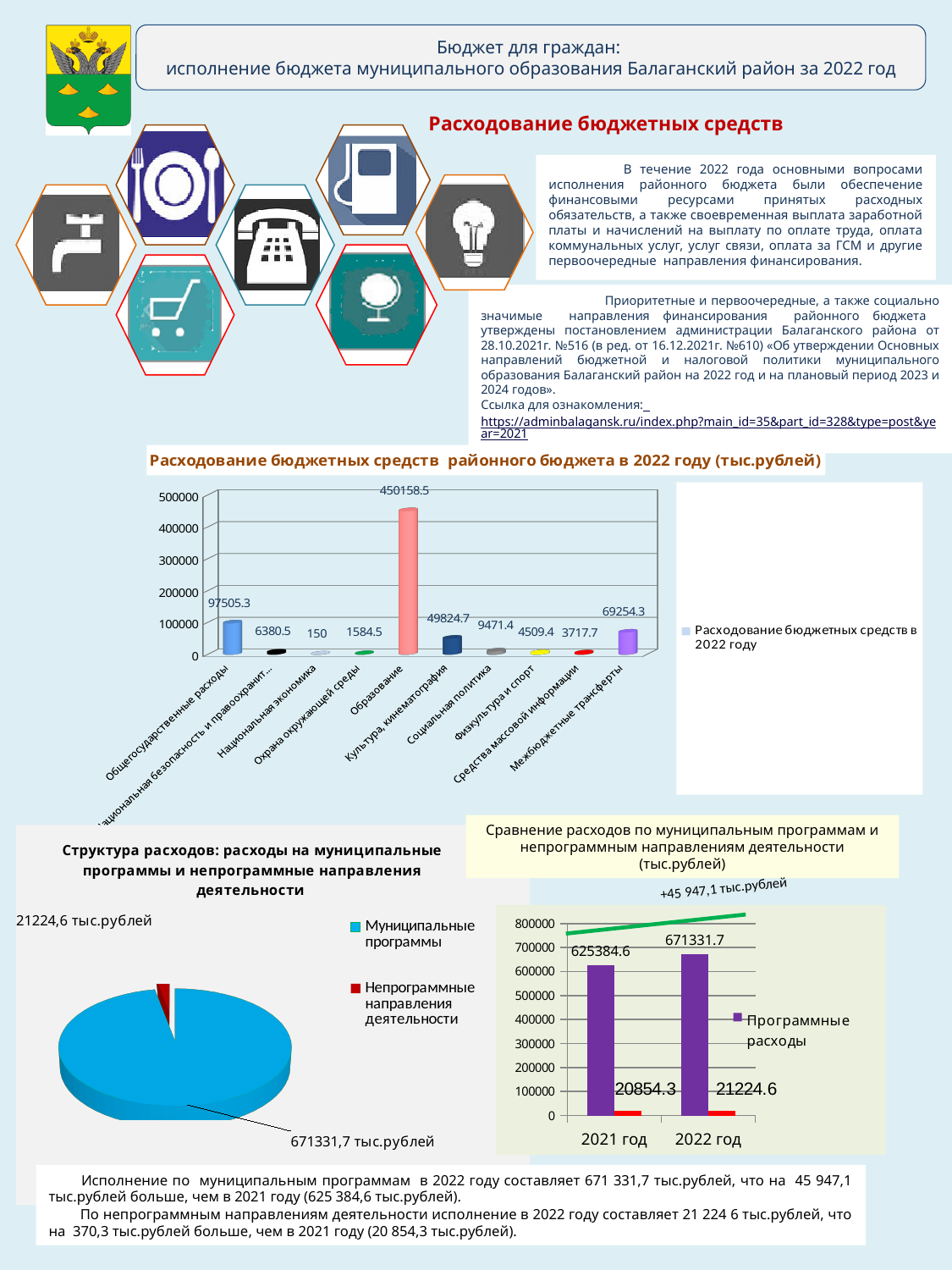
In the pie chart 'Структура расходов', what is the value for Непрограммные направления деятельности? 21224,6 тыс.рублей In the chart 'Расходование бюджетных средств районного бюджета в 2022 году (тыс.рублей)', what is the difference between Социальная политика and Физкультура и спорт? 4962 In the chart 'Сравнение расходов по муниципальным программам и непрограммным направлениям деятельности (тыс.рублей)', do the Программные расходы rise or fall from 2021 год to 2022 год? Rise In the chart 'Расходование бюджетных средств районного бюджета в 2022 году (тыс.рублей)', which category has the lowest value? Национальная экономика In the chart 'Расходование бюджетных средств районного бюджета в 2022 году (тыс.рублей)', how many categories are shown? 10 What kind of chart is 'Структура расходов: расходы на муниципальные программы и непрограммные направления деятельности'? Pie chart In the chart 'Расходование бюджетных средств районного бюджета в 2022 году (тыс.рублей)', what is the value for Образование? 450158.5 In the chart 'Сравнение расходов по муниципальным программам и непрограммным направлениям деятельности (тыс.рублей)', what is the difference between the Программные расходы for 2022 год and 2021 год? 45947.1 In the chart 'Сравнение расходов по муниципальным программам и непрограммным направлениям деятельности (тыс.рублей)', what is the value of Программные расходы for 2021 год? 625384.6 In the chart 'Расходование бюджетных средств районного бюджета в 2022 году (тыс.рублей)', which is larger: Общегосударственные расходы or Культура, кинематография? Общегосударственные расходы In the chart 'Расходование бюджетных средств районного бюджета в 2022 году (тыс.рублей)', what is the value for Межбюджетные трансферты? 69254.3 In the chart 'Расходование бюджетных средств районного бюджета в 2022 году (тыс.рублей)', which category has the highest value? Образование